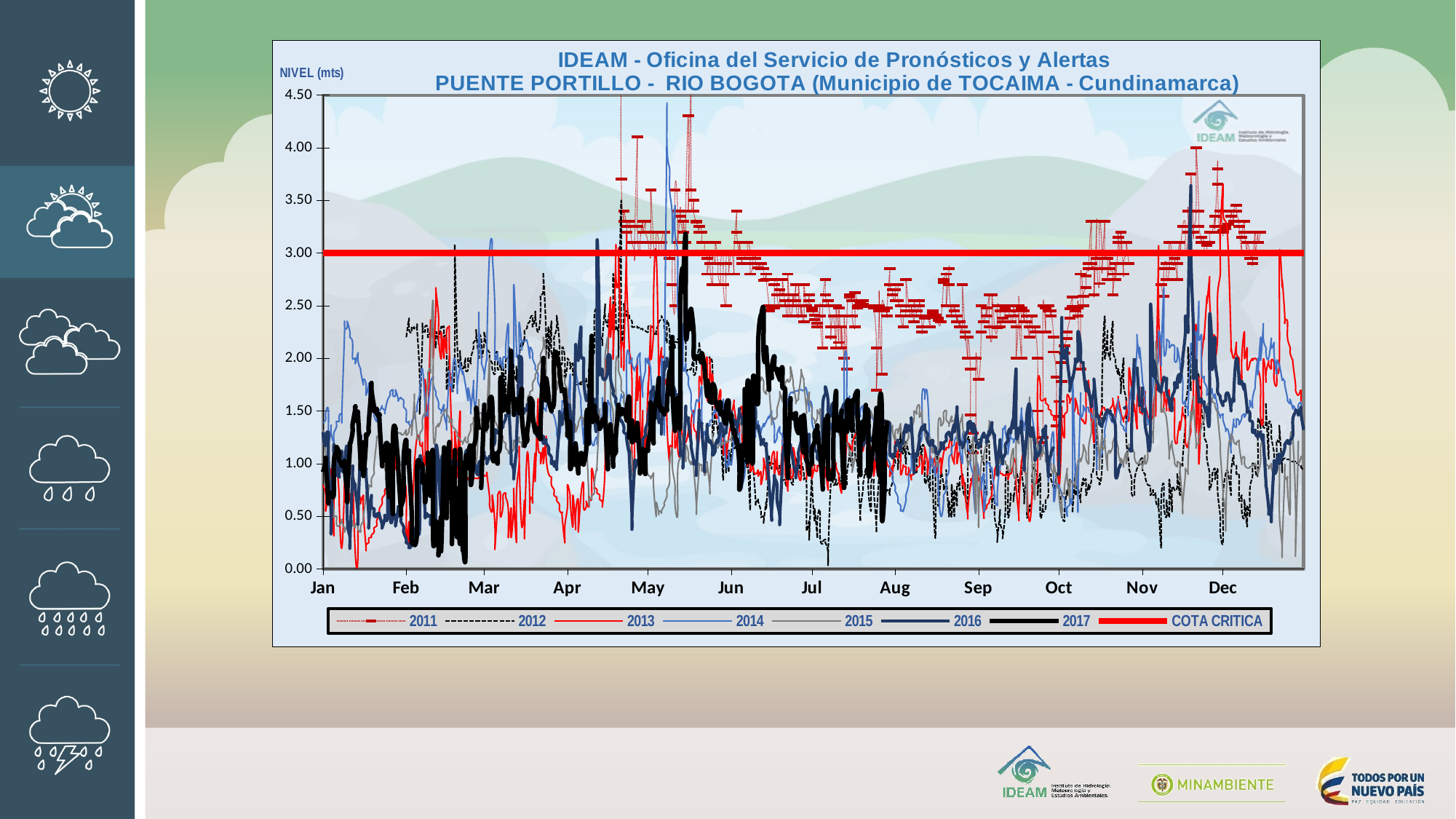
What is the value of the COTA CRITICA line? 3.00 What is the label of the y axis? NIVEL (mts) What kind of chart is shown on the slide? line chart Is the lowest value of the 2017 series in February greater or less than 0.50? less How many months are labelled along the x axis? 12 Is the peak value of the 2016 series in late November greater or less than 3.00? greater Is the value for the 2011 series in September greater or less than 3.00? less What is the highest value shown on the y axis? 4.50 How many series does the legend list? 8 Which station and river does the chart title name? PUENTE PORTILLO - RIO BOGOTA